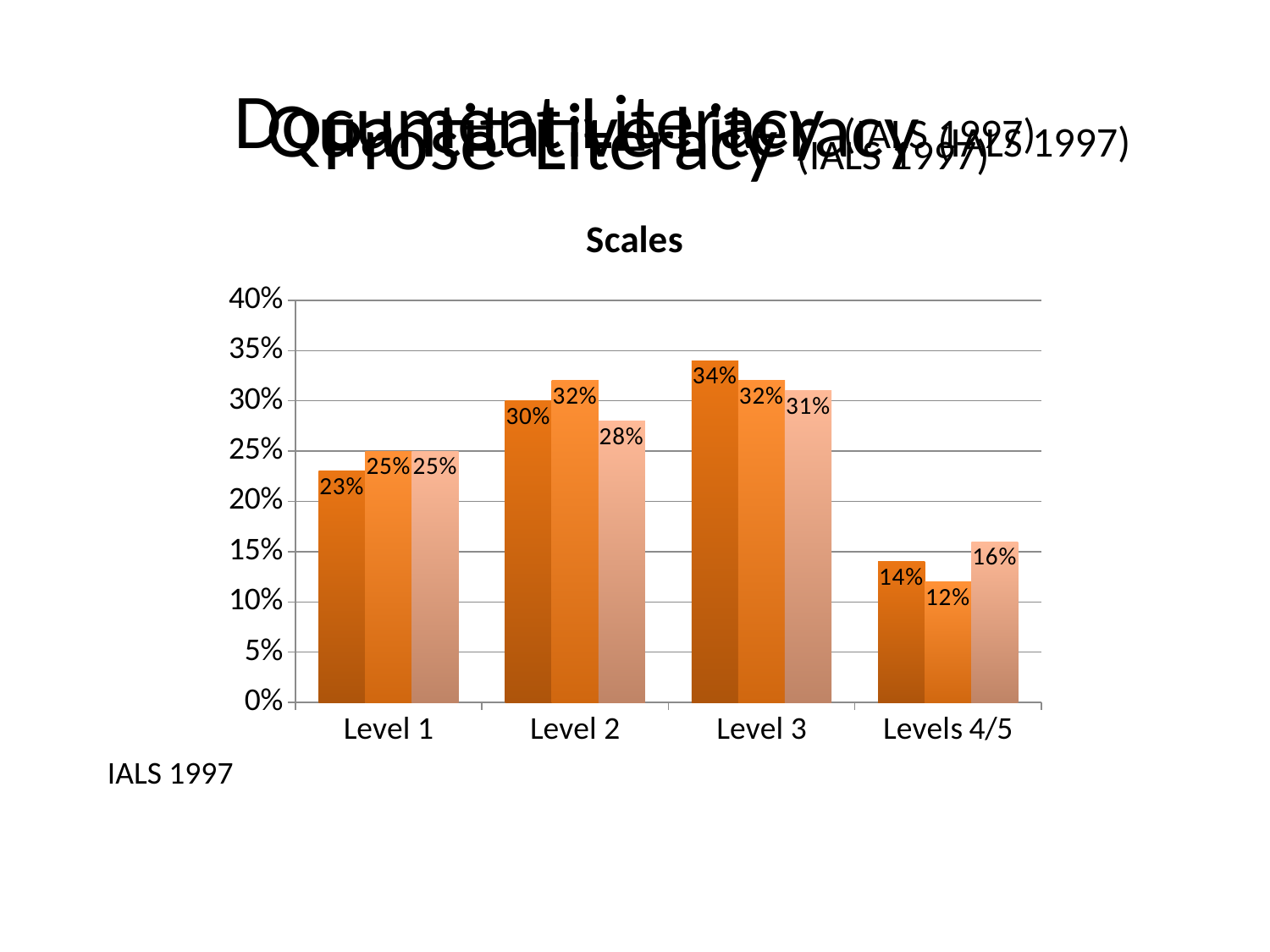
Among the first (darkest) bars, which category has the highest value? Level 3 What is the value of the second (middle) bar for Levels 4/5? 12% Among the third (lightest) bars, which category has the lowest value? Levels 4/5 For Level 3, what is the difference between the first (darkest) bar and the third (lightest) bar? 3 percentage points Which is larger: the first (darkest) bar for Level 2 or the first (darkest) bar for Level 3? Level 3 How many bars are plotted for each level category? 3 How many categories are shown on the x axis of the chart? 4 What is the value of the first (darkest) bar for Level 1? 23% What is the title of the chart? Scales What kind of chart is shown on the slide? bar chart What is the value of the third (lightest) bar for Level 2? 28% Is the value of the first (darkest) bar for Level 1 greater or less than 25%? less